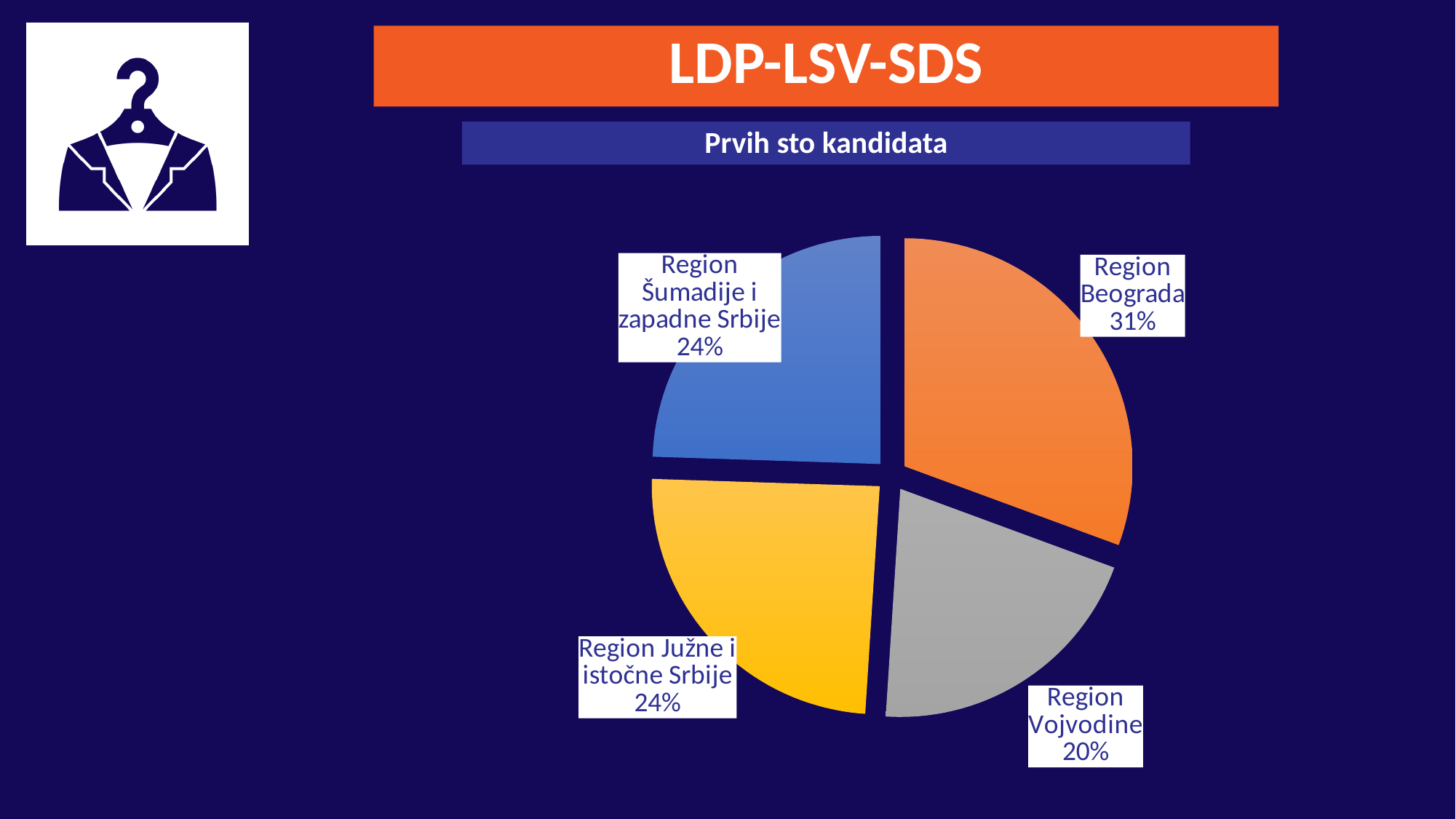
How many slices does the pie chart have? 4 What is the subtitle shown above the chart? Prvih sto kandidata What share of the pie does Region Šumadije i zapadne Srbije have? 24% What share of the pie does Region Vojvodine have? 20% What share of the pie does Region Južne i istočne Srbije have? 24% Which region has the largest share of the pie? Region Beograda What is the difference in percentage points between Region Beograda and Region Vojvodine? 11 Which region has the smallest share of the pie? Region Vojvodine What kind of chart is shown on the slide? Pie chart Which is larger, the share for Region Beograda or the share for Region Šumadije i zapadne Srbije? Region Beograda What share of the pie does Region Beograda have? 31% What colour is the slice for Region Vojvodine? Grey